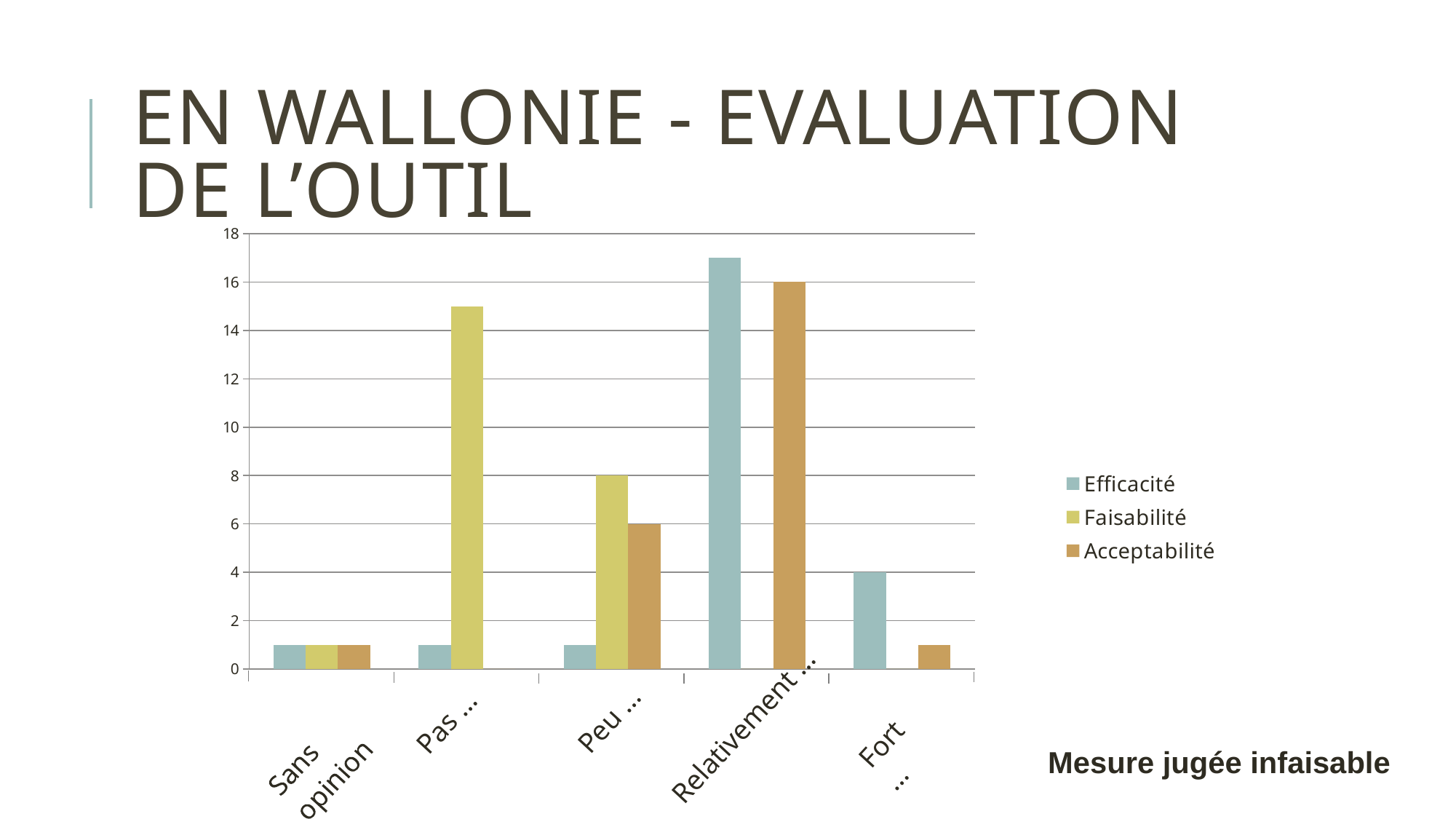
What is the Faisabilité value for the "Peu …" category? 8 Which category has the highest Efficacité value? Relativement … Is the Faisabilité value for "Pas …" greater or less than 14? greater In the "Peu …" category, which is larger: Faisabilité or Acceptabilité? Faisabilité How many series does the legend list? 3 Which category has the highest Faisabilité value? Pas … What is the Acceptabilité value for the "Relativement …" category? 16 How many categories are shown on the x axis? 5 In the "Peu …" category, what is the difference between the Faisabilité and Acceptabilité values? 2 What is the Efficacité value for the "Fort …" category? 4 What is the Acceptabilité value for the "Peu …" category? 6 What kind of chart is shown on the slide? Bar chart